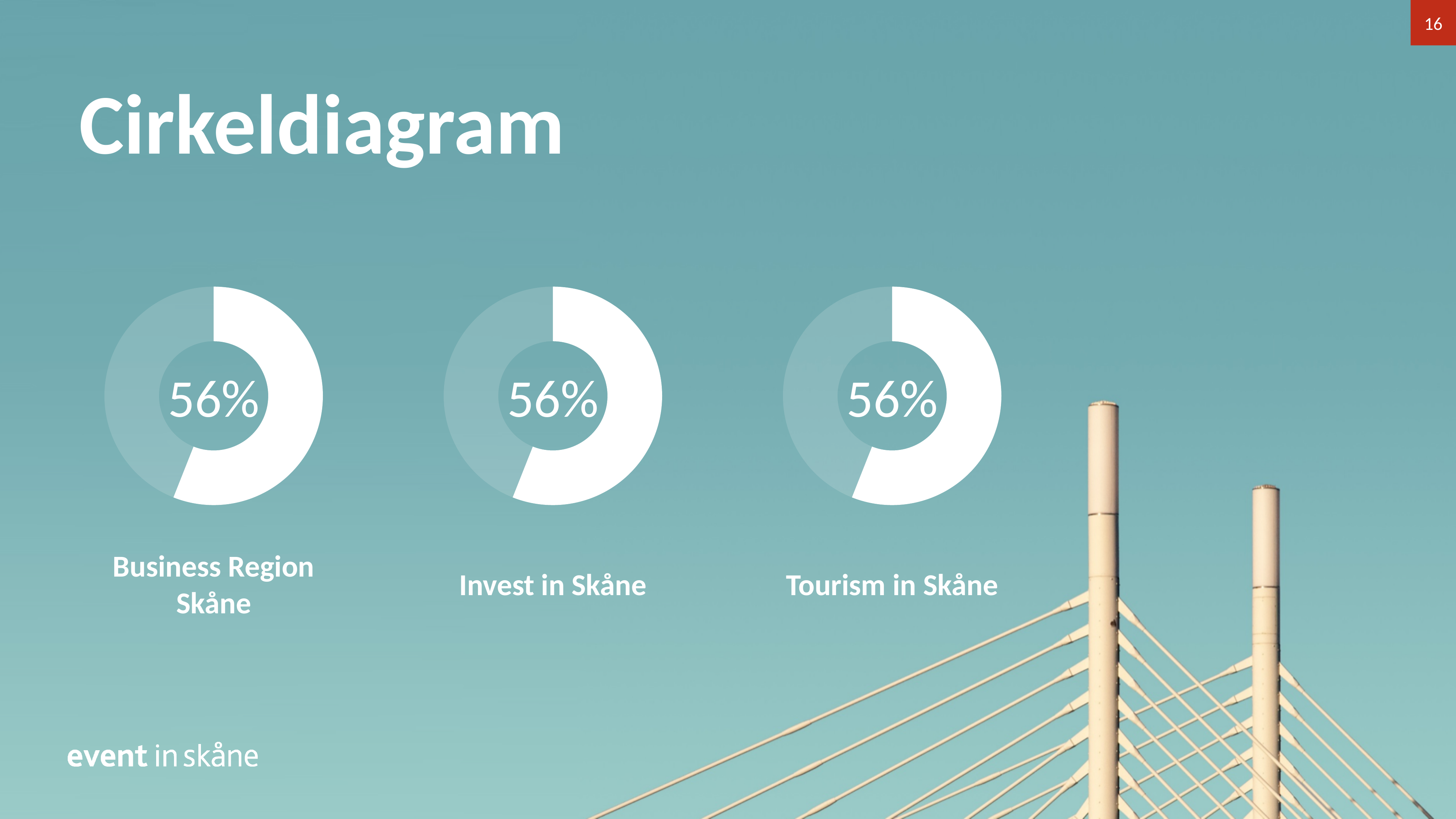
What value is shown in the Business Region Skåne donut chart? 56% Do the three donut charts (Business Region Skåne, Invest in Skåne, Tourism in Skåne) all show the same value? Yes, 56% What kind of chart is used for Business Region Skåne? Donut (pie) chart What value is shown in the Tourism in Skåne donut chart? 56% In the Tourism in Skåne donut chart, what share of the ring is filled in white? 56% What is the title of the slide containing the three donut charts? Cirkeldiagram Is the value shown in the Invest in Skåne donut chart greater or less than 50%? greater Which label appears under the middle donut chart? Invest in Skåne How many donut charts are shown on the slide? 3 What value is shown in the Invest in Skåne donut chart? 56%